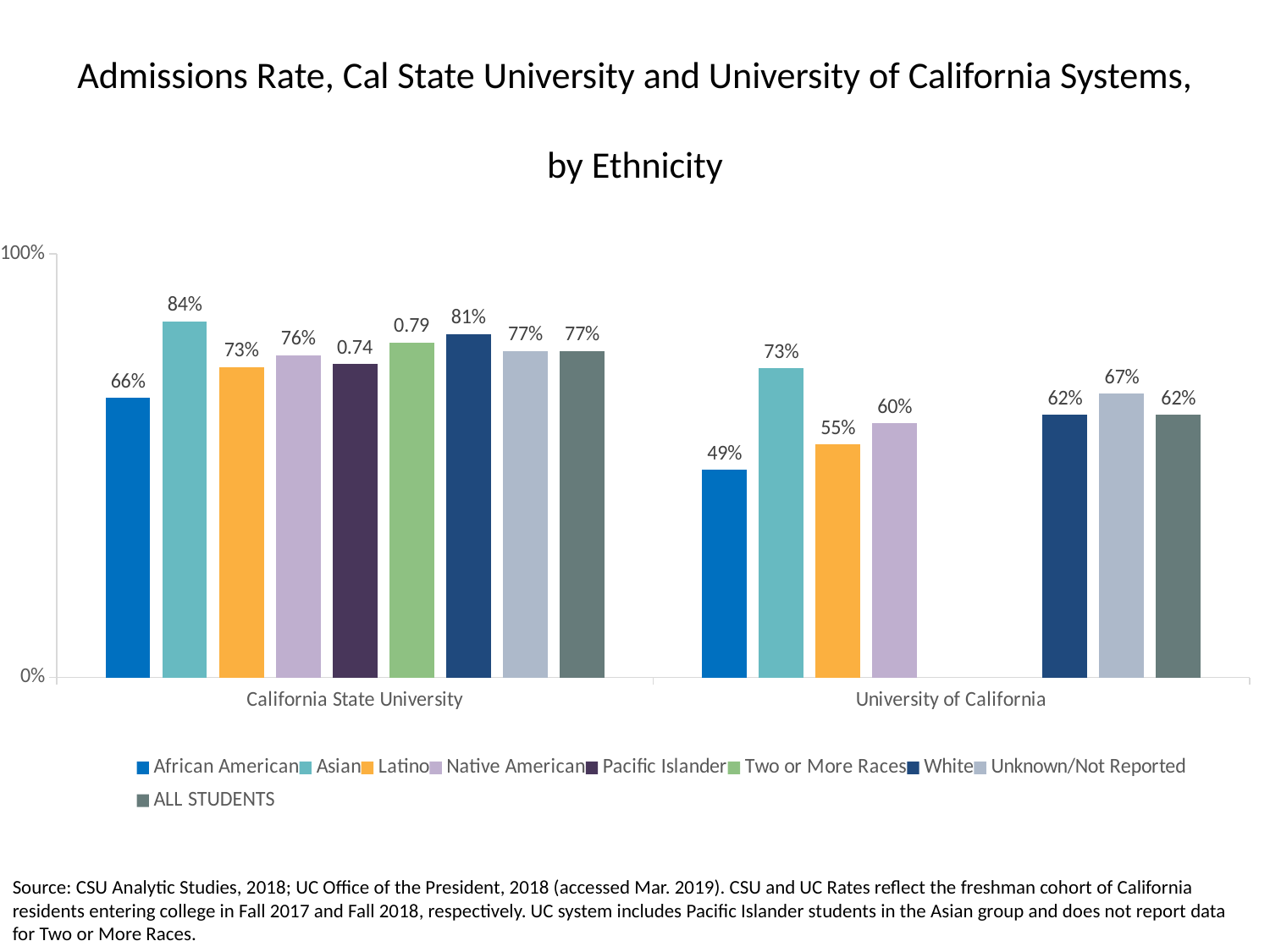
Which ethnicity group has the highest admissions rate at California State University? Asian What is the admissions rate for ALL STUDENTS at the University of California? 62% How many series does the legend list? 9 What kind of chart is shown on the slide? Bar chart What is the difference between the Asian admissions rate at California State University and at the University of California? 11% Which ethnicity group has the lowest admissions rate at the University of California? African American Which is larger: the Latino admissions rate at California State University or at the University of California? California State University What is the admissions rate for Asian students at California State University? 84% What value is shown for Pacific Islander students at California State University? 0.74 What colour are the bars for White students? Dark blue How many university systems are shown on the x axis? 2 What is the admissions rate for African American students at the University of California? 49%